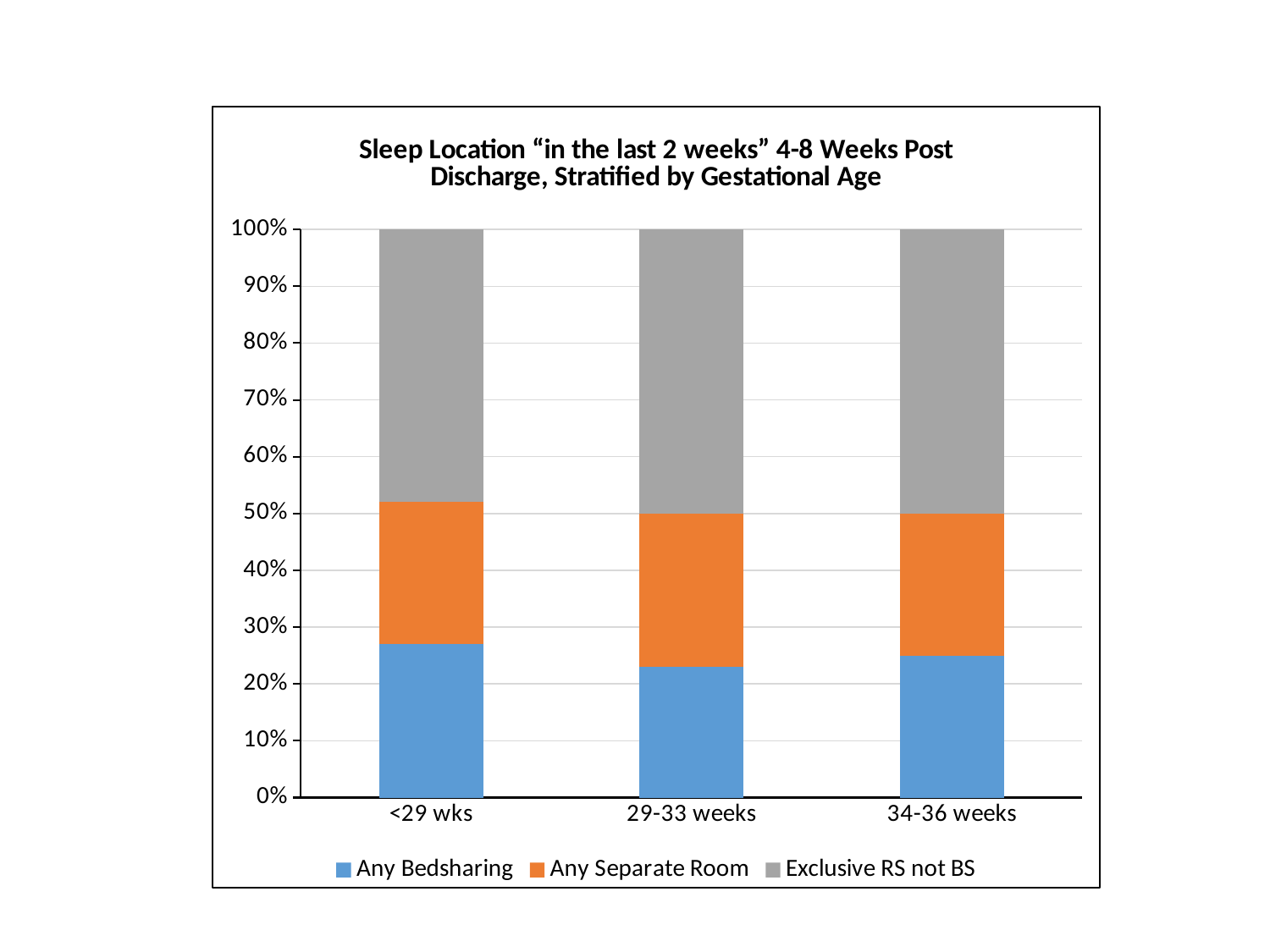
Which has the larger Any Bedsharing value, <29 wks or 29-33 weeks? <29 wks Which gestational age category has the highest Any Bedsharing value? <29 wks Is the Any Bedsharing value for 34-36 weeks greater or less than 20%? greater Which series is shown in blue in the legend? Any Bedsharing Is the Any Bedsharing value for <29 wks greater or less than 20%? greater What is the total of the stacked bar for 29-33 weeks? 100% What kind of chart is shown on the slide? bar chart Is the Exclusive RS not BS segment for 29-33 weeks greater or less than 40% of the bar? greater How many gestational age categories are shown on the x axis? 3 What is the title of the chart? Sleep Location "in the last 2 weeks" 4-8 Weeks Post Discharge, Stratified by Gestational Age How many series does the legend list? 3